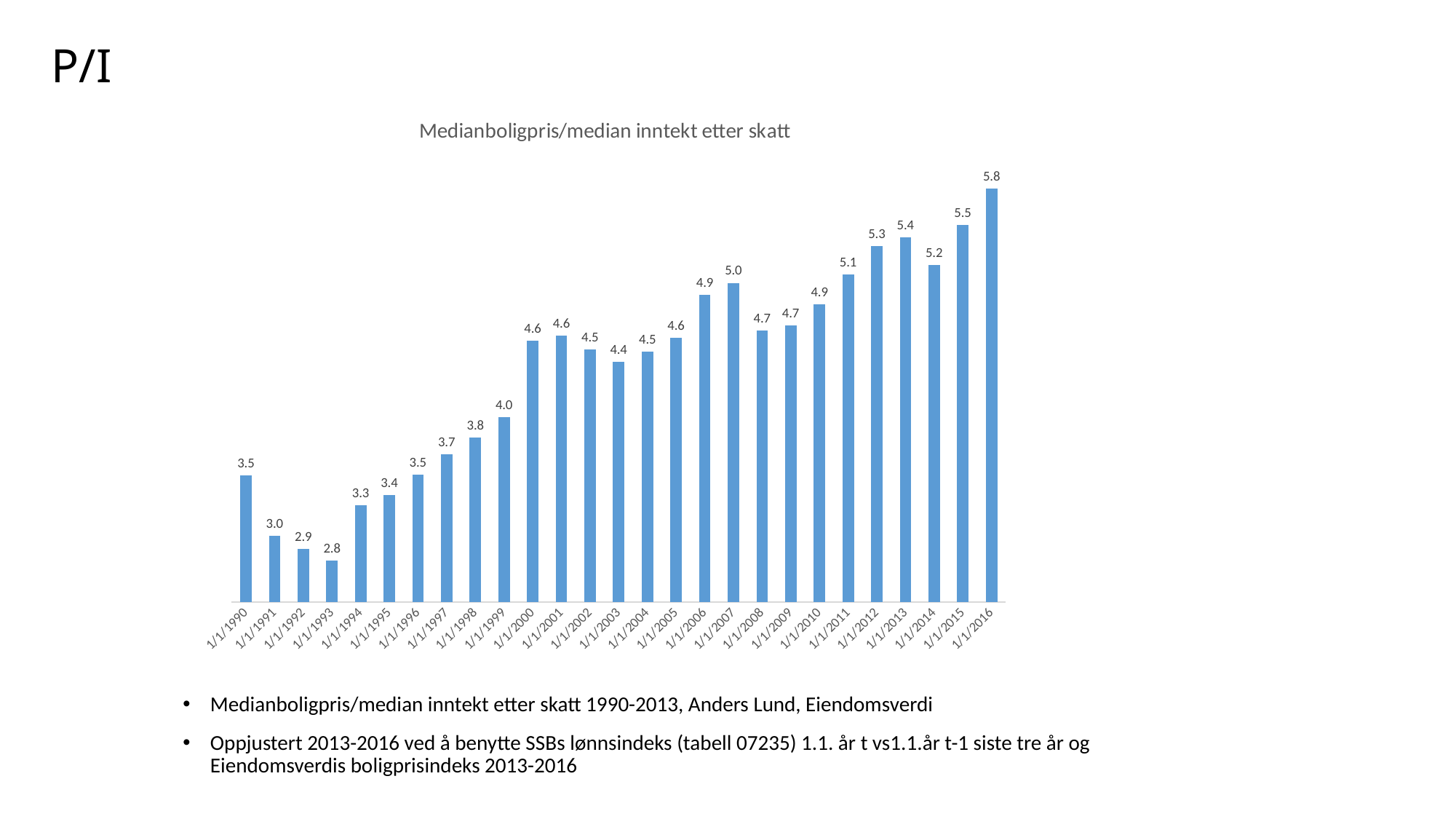
What is the difference between the values for 1/1/2016 and 1/1/1990? 2.3 How many bars are shown in the chart? 27 Which year has the highest value? 1/1/2016 Do the values generally rise or fall from 1/1/1993 to 1/1/2007? rise Which is larger, the value for 1/1/2013 or the value for 1/1/2014? 1/1/2013 What is the value for 1/1/1993? 2.8 What is the title of the chart? Medianboligpris/median inntekt etter skatt What is the difference between the values for 1/1/2008 and 1/1/2007? 0.3 What is the value for 1/1/2007? 5.0 What kind of chart is shown on the slide? bar chart Which year has the lowest value? 1/1/1993 What is the value for 1/1/2016? 5.8